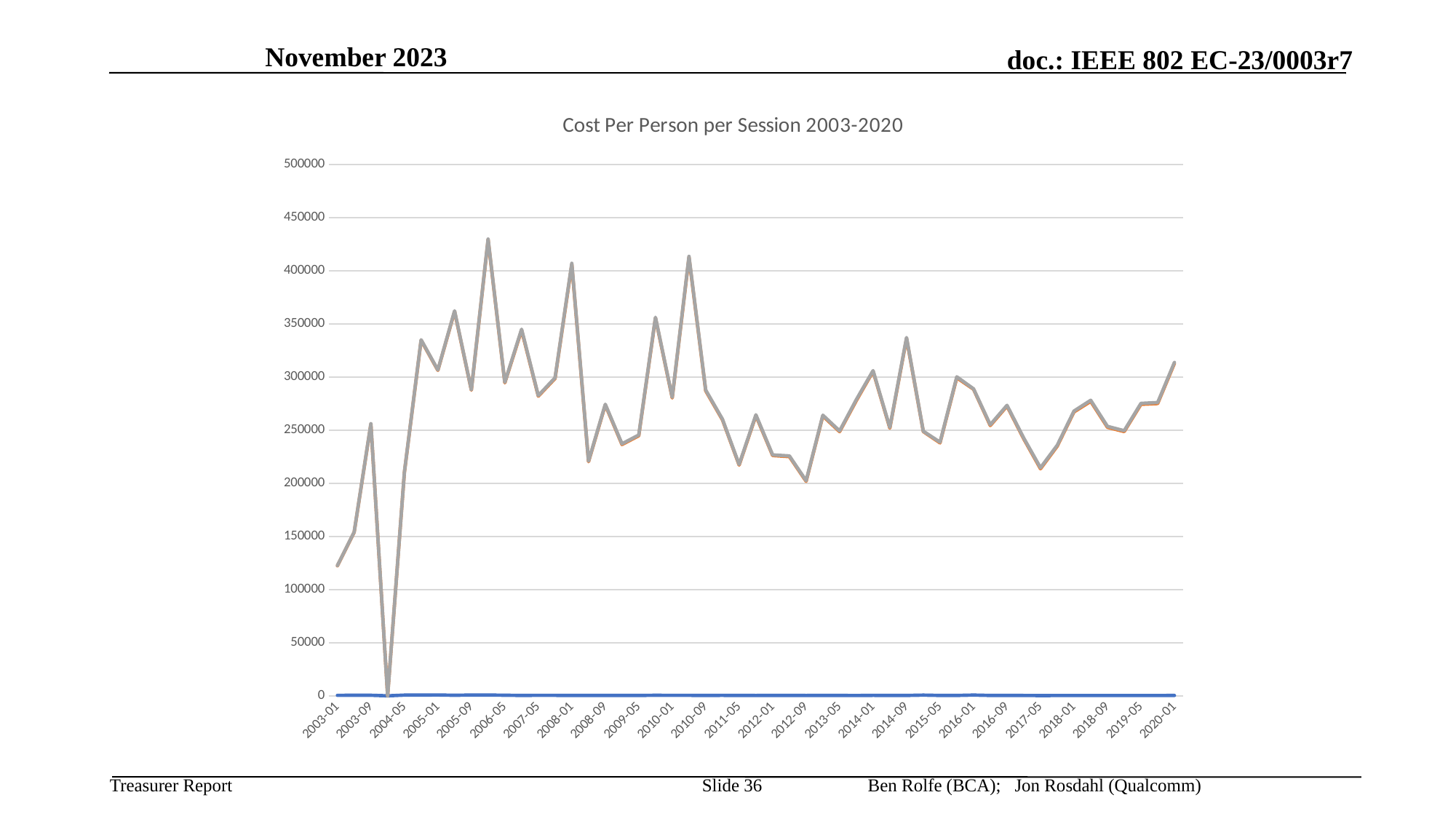
What kind of chart is shown on the slide? line chart Is the value for 2017-05 greater or less than 250000? less Which is larger, the value for 2003-01 or the value for 2020-01? 2020-01 What is the title of the chart? Cost Per Person per Session 2003-2020 Is the value for 2008-01 greater or less than 350000? greater Which is larger, the value for 2008-01 or the value for 2012-09? 2008-01 What is the highest value shown on the vertical axis? 500000 Does the line rise or fall between 2019-05 and 2020-01? rise Is the value for 2003-01 greater or less than 100000? greater